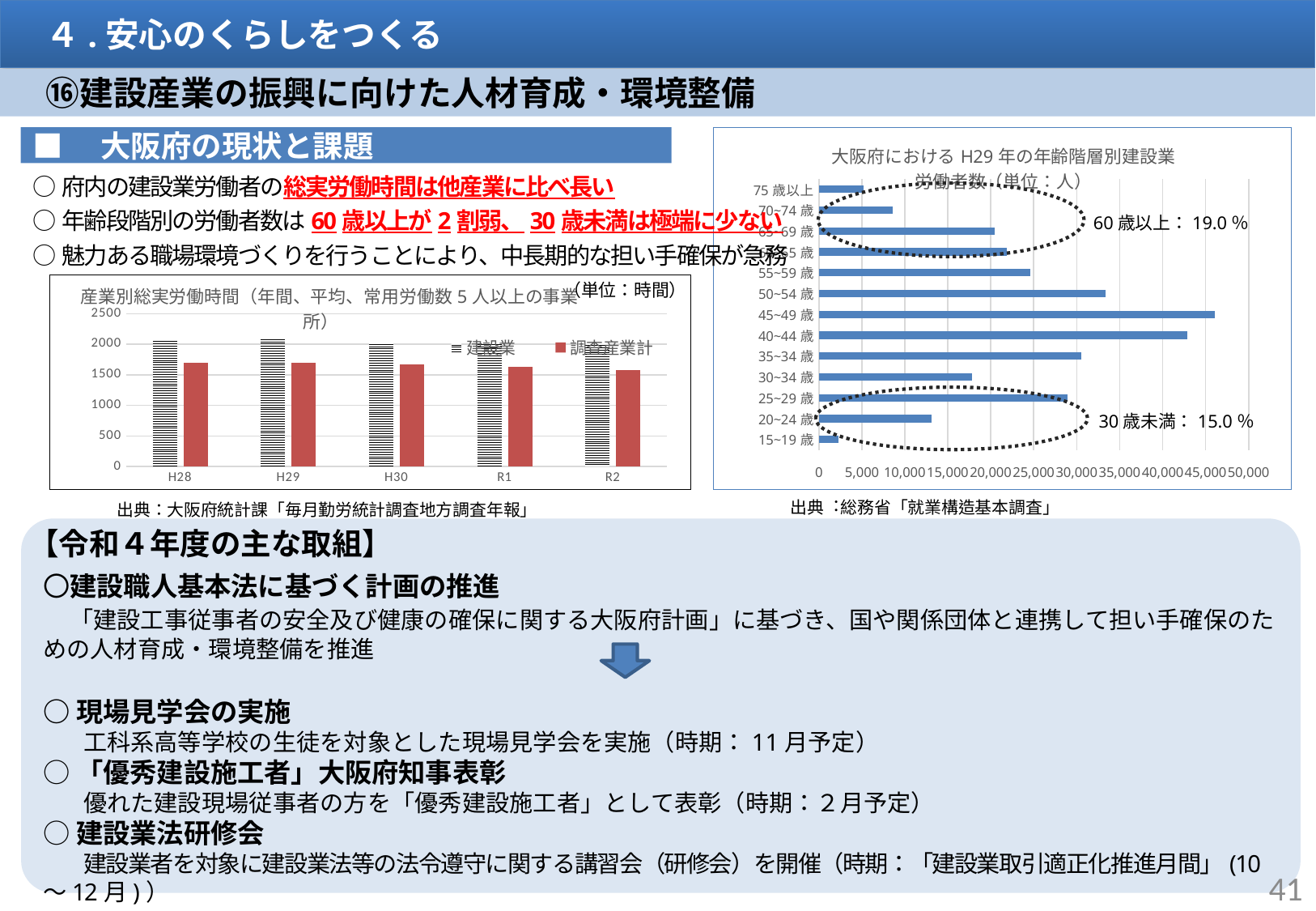
In the left-hand chart (産業別総実労働時間), how many years are shown on the x axis? 5 In the right-hand chart (年齢階層別建設業労働者数), which age group has the highest number of workers? 45~49歳 In the right-hand chart (年齢階層別建設業労働者数), is the value for 20~24歳 greater or less than 15,000? less What kind of chart is the right-hand chart titled 大阪府におけるH29年の年齢階層別建設業労働者数? bar chart In the left-hand chart (産業別総実労働時間), for H28, which series is larger, 建設業 or 調査産業計? 建設業 In the right-hand chart (年齢階層別建設業労働者数), which has more workers, 40~44歳 or 35~34歳? 40~44歳 In the right-hand chart (年齢階層別建設業労働者数), is the value for 45~49歳 greater or less than 40,000? greater In the left-hand chart (産業別総実労働時間), is the 調査産業計 value for R2 greater or less than 2000? less In the left-hand chart (産業別総実労働時間), how many series does the legend list? 2 In the right-hand chart (年齢階層別建設業労働者数), which age group has the lowest number of workers? 15~19歳 In the right-hand chart (年齢階層別建設業労働者数), how many age categories are plotted? 13 In the right-hand chart (年齢階層別建設業労働者数), what percentage is shown for 60歳以上? 19.0%